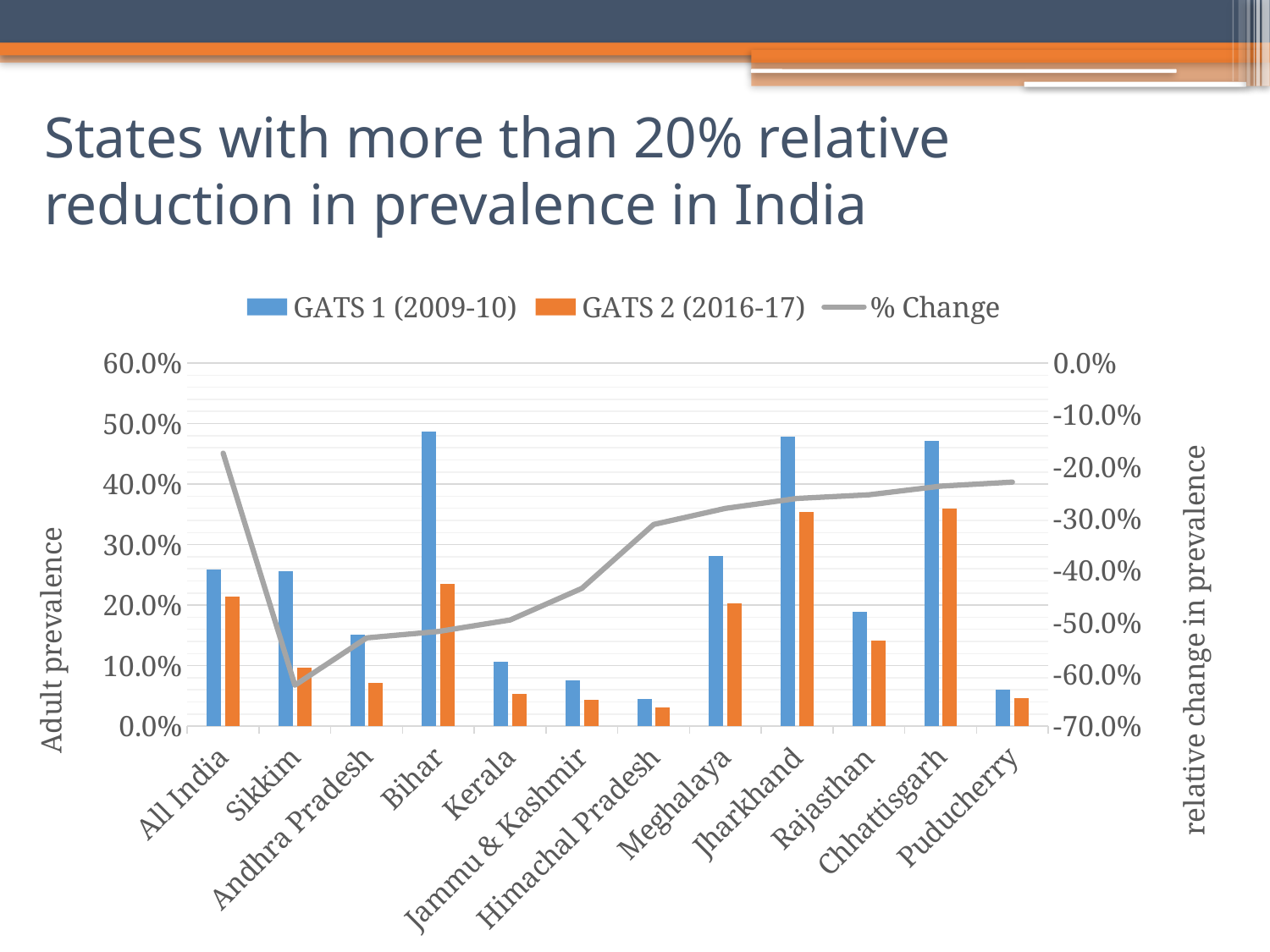
Is the GATS 1 (2009-10) value for All India greater or less than 20.0%? greater For Bihar, which is larger: the GATS 1 (2009-10) value or the GATS 2 (2016-17) value? GATS 1 (2009-10) Is the GATS 1 (2009-10) value for Kerala greater or less than 20.0%? less How many states/categories are shown on the x axis? 12 Is the GATS 2 (2016-17) value for Jharkhand greater or less than 30.0%? greater Which category has the lowest (most negative) % Change value? Sikkim What kind of chart is this? Combined bar and line chart How many series does the legend list? 3 Which category has the lowest GATS 1 (2009-10) value? Himachal Pradesh What is the title of the left vertical axis? Adult prevalence Which is larger: the GATS 1 (2009-10) value for Meghalaya or for Rajasthan? Meghalaya